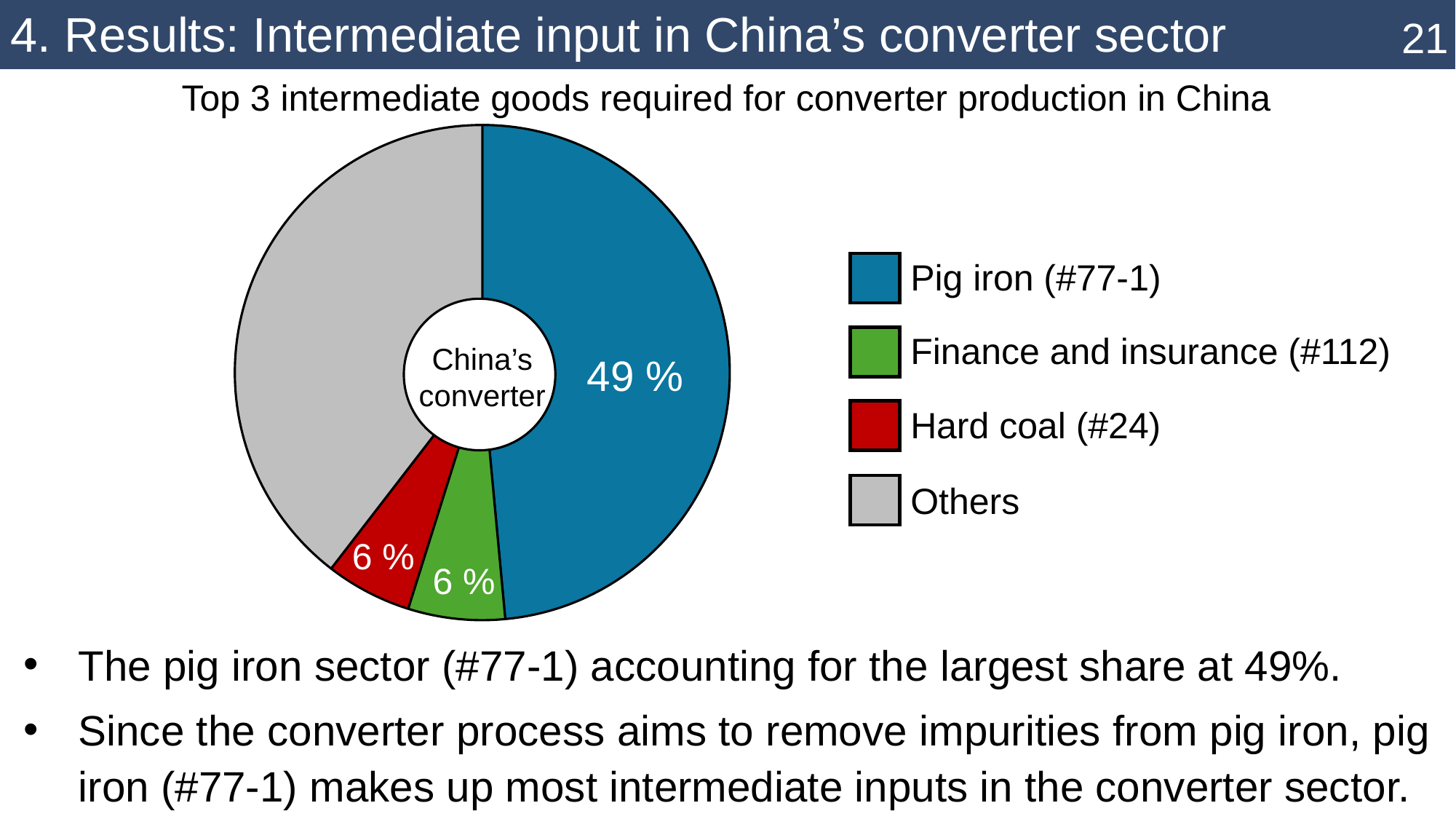
What share of the pie does Finance and insurance (#112) account for? 6 % Is the share for Pig iron (#77-1) greater or less than 40 %? greater What kind of chart is shown on the slide? Pie chart How many entries does the legend list? 4 What text appears in the centre of the pie chart? China's converter Which is larger, the slice for Pig iron (#77-1) or the slice for Hard coal (#24)? Pig iron (#77-1) What is the title of the chart? Top 3 intermediate goods required for converter production in China How many slices does the pie chart have? 4 What share of the pie does Hard coal (#24) account for? 6 % Which category has the largest slice of the pie? Pig iron (#77-1) What share of the pie does Pig iron (#77-1) account for? 49 % What is the difference in percentage points between the Pig iron (#77-1) slice and the Finance and insurance (#112) slice? 43 %